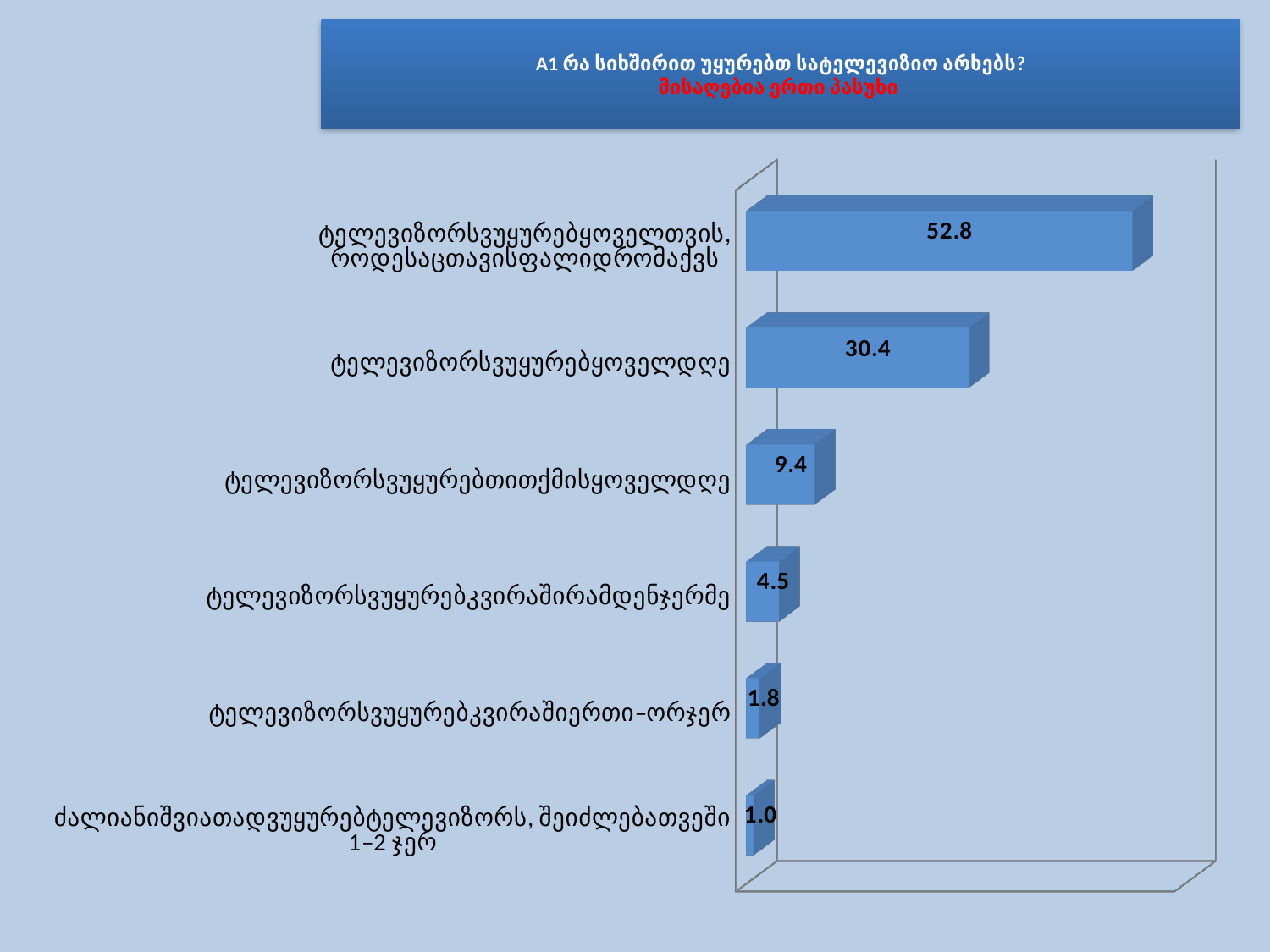
What is the value for the bottom bar, "ძალიანიშვიათადვუყურებტელევიზორს, შეიძლებათვეში 1-2 ჯერ"? 1.0 What is the question code shown at the start of the slide title? A1 What is the value for "ტელევიზორსვუყურებთითქმისყოველდღე"? 9.4 How many categories (bars) does the chart show? 6 What is the value for "ტელევიზორსვუყურებყოველდღე"? 30.4 Which category has the lowest value? ძალიანიშვიათადვუყურებტელევიზორს, შეიძლებათვეში 1-2 ჯერ What is the value for "ტელევიზორსვუყურებკვირაშირამდენჯერმე"? 4.5 What is the value for the top bar, "ტელევიზორსვუყურებყოველთვის, როდესაცთავისუფალიდროამაქვს"? 52.8 Which category has the highest value? ტელევიზორსვუყურებყოველთვის, როდესაცთავისფალიდრომაქვს Which is larger, the value for "ტელევიზორსვუყურებკვირაშირამდენჯერმე" or for "ტელევიზორსვუყურებკვირაშიერთი-ორჯერ"? ტელევიზორსვუყურებკვირაშირამდენჯერმე What type of chart is shown on the slide? bar chart What is the difference between the values for "ტელევიზორსვუყურებყოველთვის, როდესაცთავისუფალიდროამაქვს" and "ტელევიზორსვუყურებყოველდღე"? 22.4